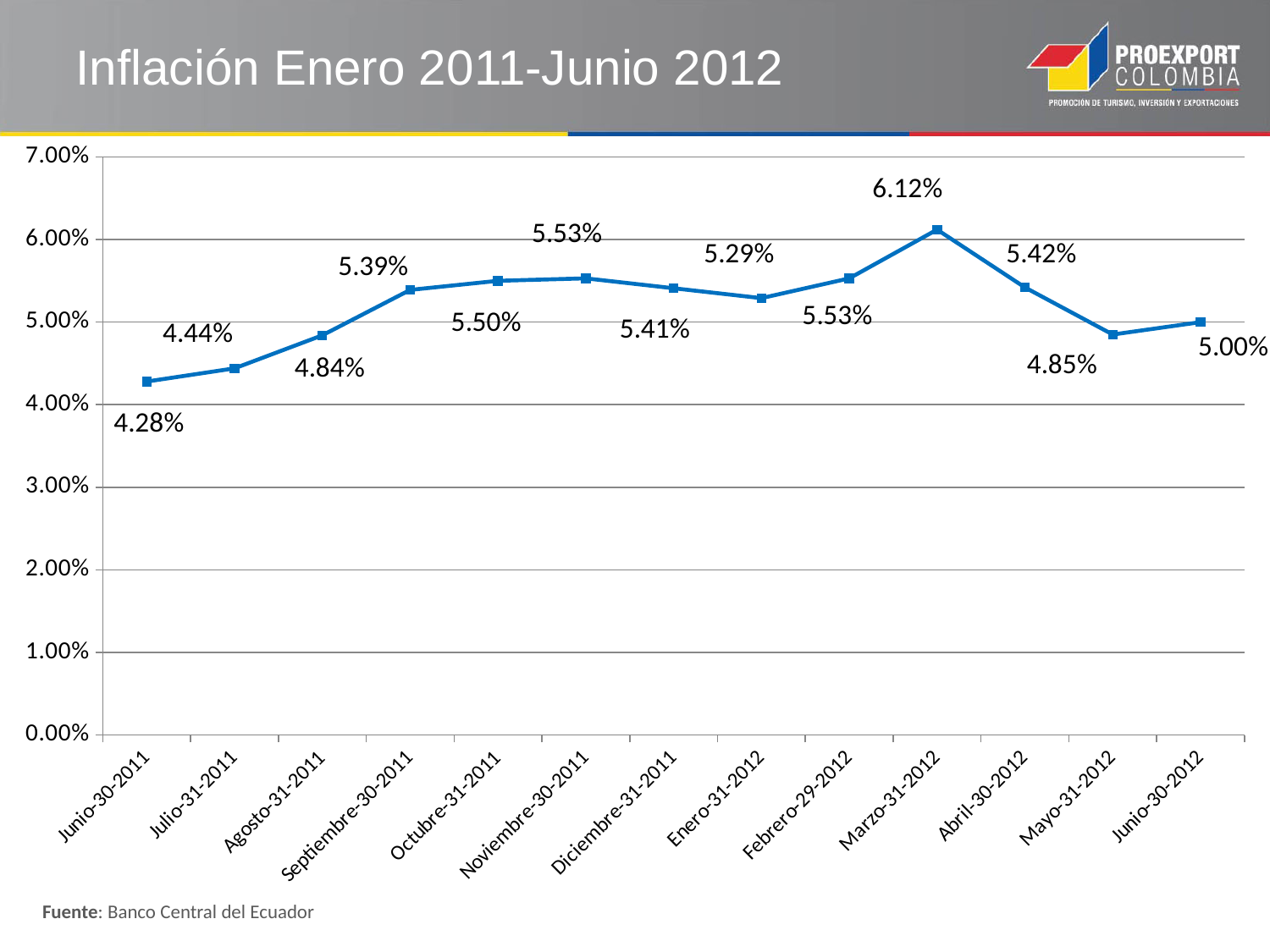
Which date has the lowest inflation value? Junio-30-2011 What is the inflation value for Marzo-31-2012? 6.12% Which is larger, the inflation value for Septiembre-30-2011 or for Mayo-31-2012? Septiembre-30-2011 Which date has the highest inflation value? Marzo-31-2012 Is the inflation value for Agosto-31-2011 greater or less than 5.00%? less What source is cited for the chart data? Banco Central del Ecuador What is the difference between the inflation values for Marzo-31-2012 and Abril-30-2012? 0.70% What is the inflation value for Junio-30-2011? 4.28% What is the inflation value for Enero-31-2012? 5.29% How many data points are plotted on the line? 13 What is the inflation value for Junio-30-2012? 5.00% What kind of chart is shown on the slide? line chart